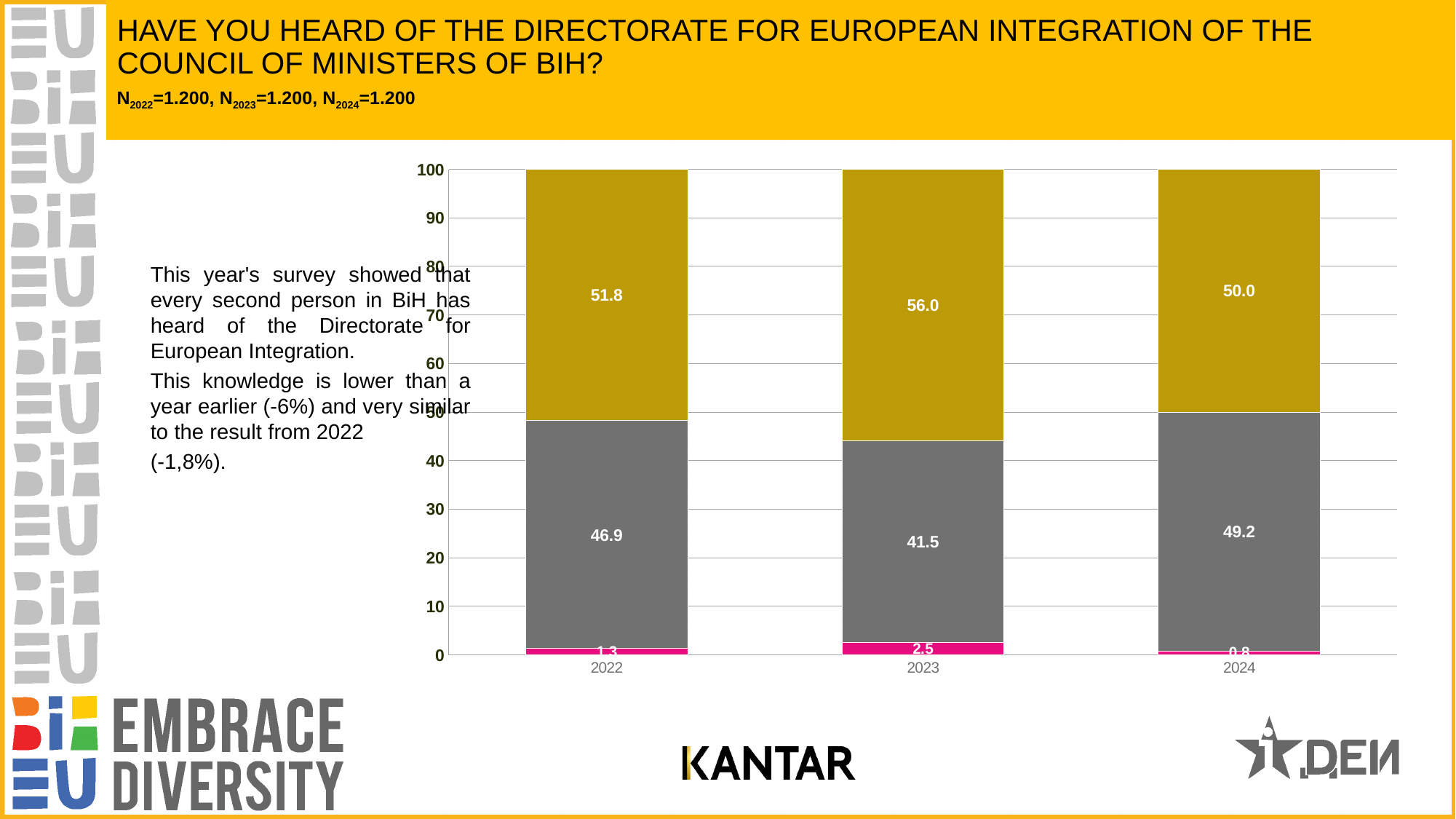
How many years (categories) are shown on the x axis of the chart? 3 What is the value of the gold (top) segment for 2023? 56.0 In which year is the gold (top) segment the highest? 2023 What is the difference between the gold segment values for 2023 and 2024? 6.0 Which is larger: the grey segment for 2022 or the grey segment for 2023? 2022 In which year is the pink (bottom) segment the lowest? 2024 What type of chart is shown on the slide? Stacked bar chart What is the value of the pink (bottom) segment for 2022? 1.3 What sample size is stated for each survey year in the subtitle? 1.200 Does the grey segment value rise or fall from 2022 to 2023? Fall What is the value of the grey (middle) segment for 2024? 49.2 What is the total of the stacked bar for 2022? 100.0